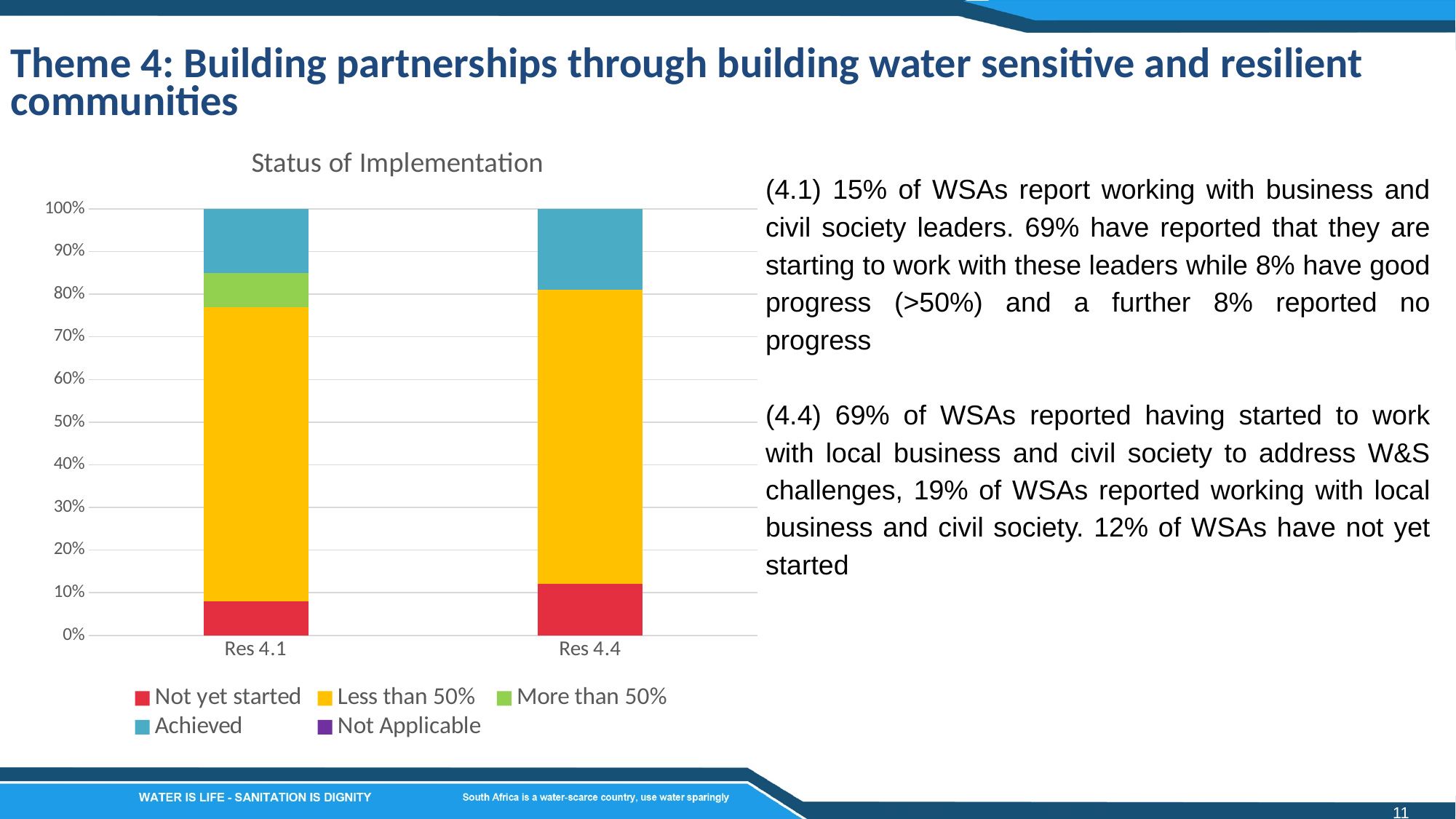
Which category does not have a 'More than 50%' segment in its bar? Res 4.4 Which series has the largest segment in the Res 4.4 bar? Less than 50% Is the 'Not yet started' value for Res 4.1 greater or less than 10%? less Which series has the largest segment in the Res 4.1 bar? Less than 50% What kind of chart is shown on the slide? Stacked bar chart How many categories are shown on the x axis of the chart? 2 How many series does the chart legend list? 5 Is the 'Achieved' value for Res 4.4 greater or less than 10%? greater Is the 'Less than 50%' value for Res 4.4 greater or less than 60%? greater Is the 'Not yet started' segment larger for Res 4.1 or Res 4.4? Res 4.4 What is the title of the chart? Status of Implementation